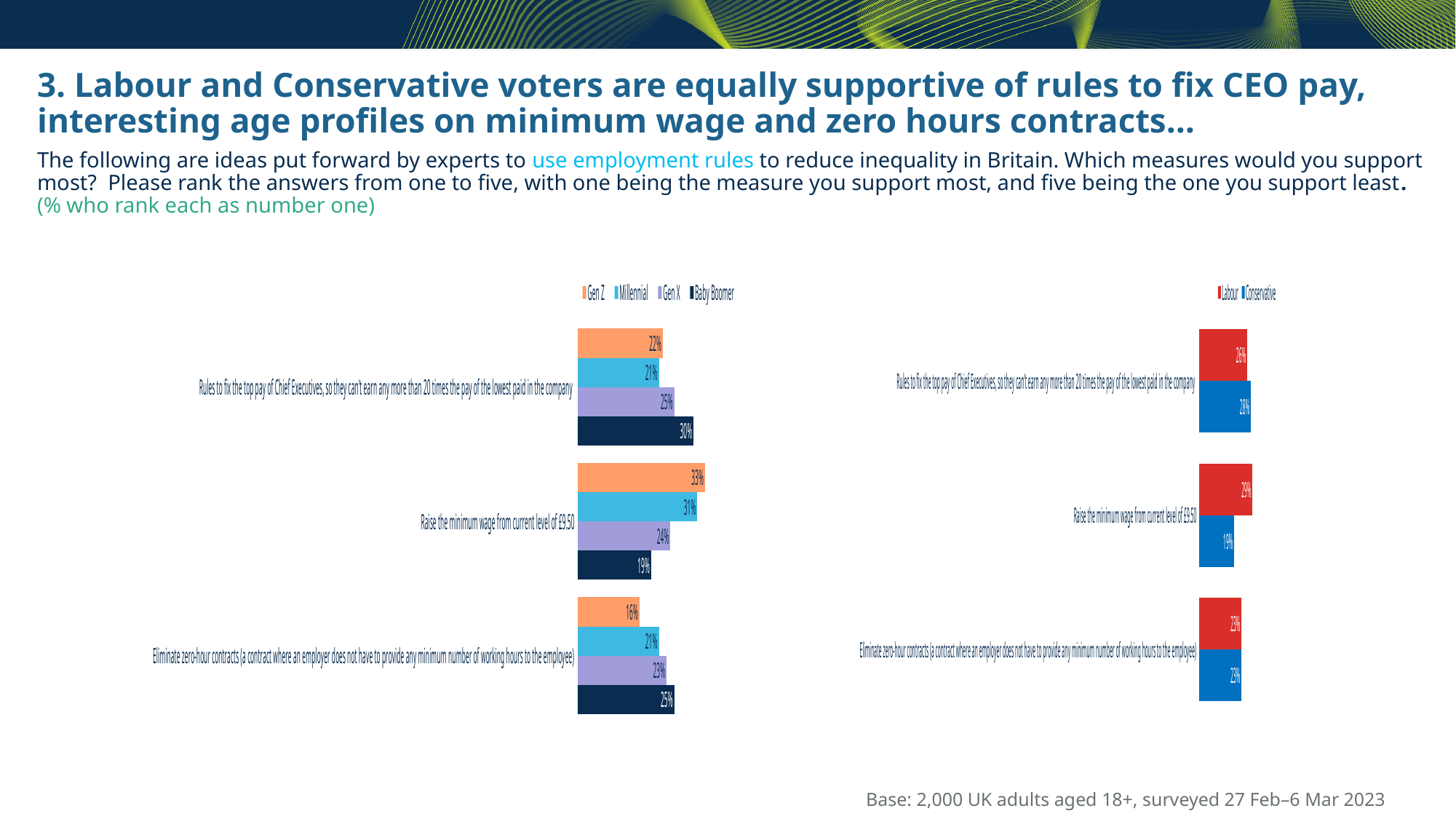
In the left chart (by generation), what is the difference between the Gen Z and Baby Boomer values for raising the minimum wage? 14 percentage points In the right chart (Labour vs Conservative), what is the difference between the Labour and Conservative values for raising the minimum wage? 10 percentage points In the right chart (Labour vs Conservative), what is the Labour value for raising the minimum wage from the current level of £9.50? 29% In the left chart (by generation), what is the Millennial value for eliminating zero-hour contracts? 21% In the left chart (by generation), what percentage of Gen Z rank raising the minimum wage from the current level of £9.50 as number one? 33% In the left chart (by generation), what percentage of Baby Boomers rank rules to fix the top pay of Chief Executives as number one? 30% What kind of chart is the right chart (Labour vs Conservative)? Bar chart In the left chart (by generation), which generation has the highest value for raising the minimum wage? Gen Z In the left chart (by generation), how many series does the legend list? 4 In the right chart (Labour vs Conservative), what percentage of Conservative voters rank rules to fix the top pay of Chief Executives as number one? 28% In the right chart (Labour vs Conservative), which is larger for raising the minimum wage: Labour or Conservative? Labour In the left chart (by generation), which generation has the lowest value for eliminating zero-hour contracts? Gen Z